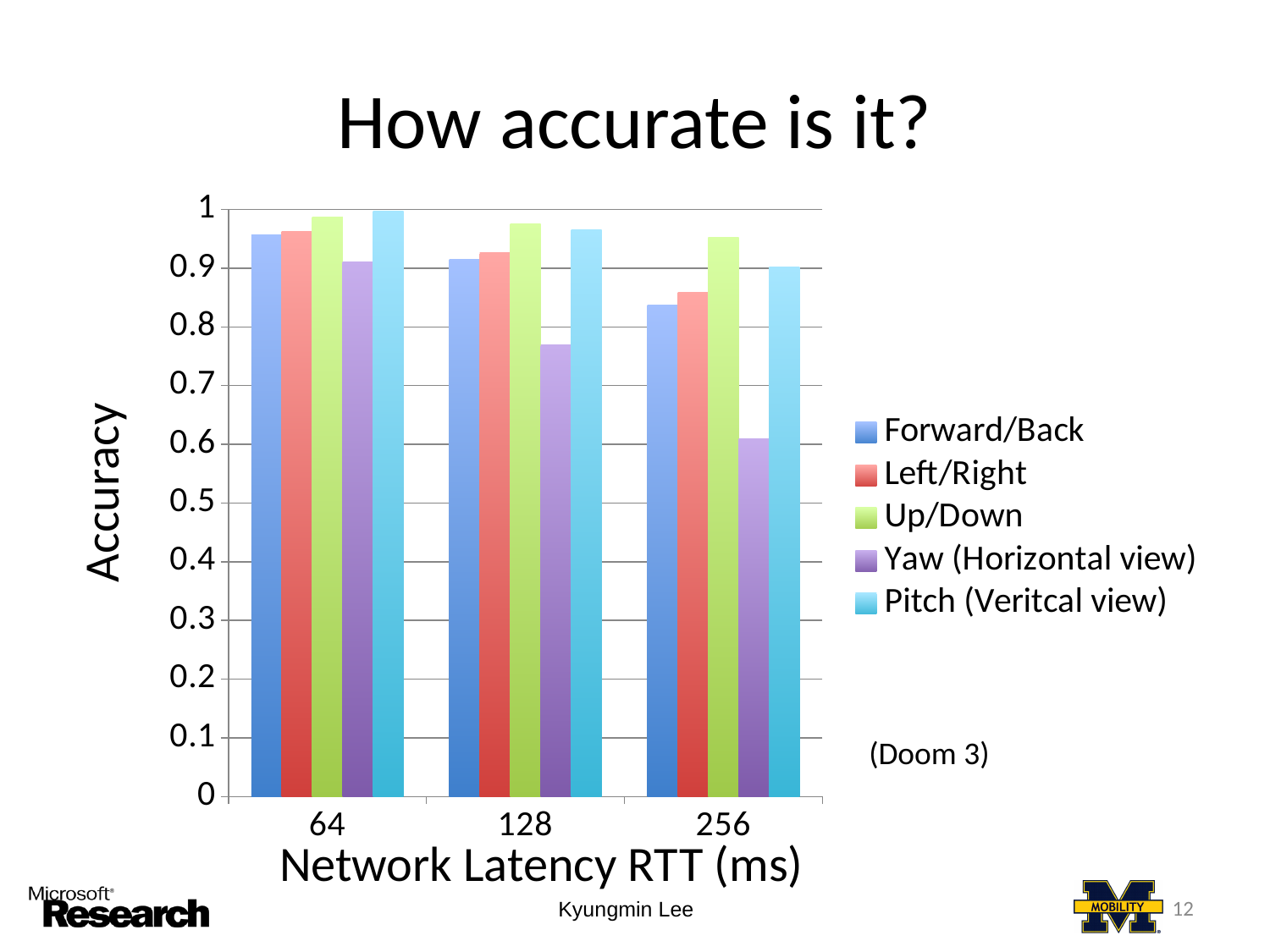
How many network latency categories are shown on the x axis? 3 At 128 ms latency, which has higher accuracy: Up/Down or Yaw (Horizontal view)? Up/Down Is the accuracy for Yaw (Horizontal view) at 256 ms greater or less than 0.7? less Does the accuracy for Yaw (Horizontal view) rise or fall as network latency increases from 64 to 256 ms? fall Is the accuracy for Forward/Back at 256 ms greater or less than 0.9? less How many series does the legend list? 5 Which series has the highest accuracy at 256 ms latency? Up/Down Is the accuracy for Yaw (Horizontal view) at 128 ms greater or less than 0.7? greater What kind of chart is shown on the slide? bar chart Which series has the lowest accuracy at 256 ms latency? Yaw (Horizontal view) Is the accuracy for Forward/Back higher at 64 ms or at 256 ms? 64 ms What is the title of the x axis? Network Latency RTT (ms)